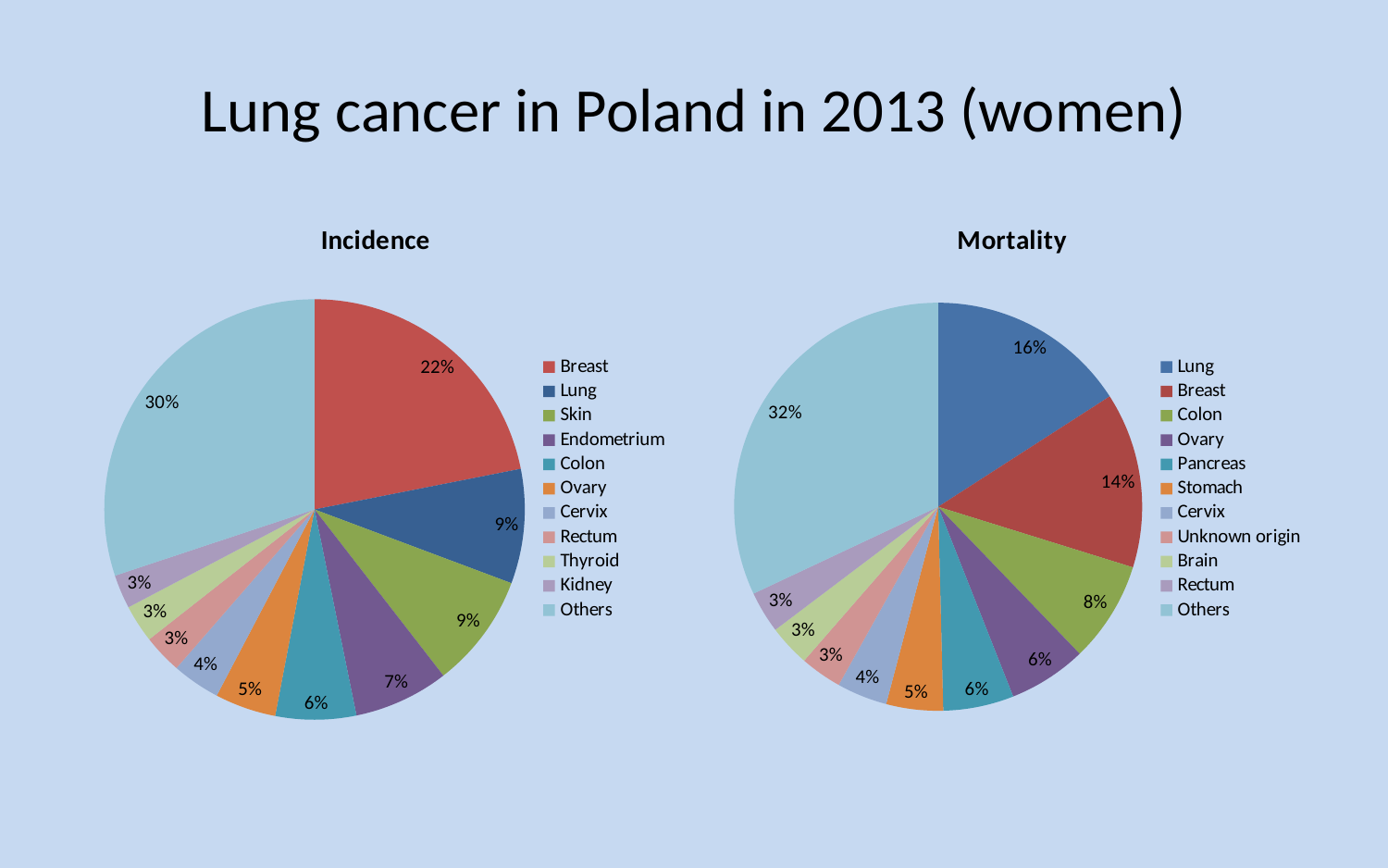
In the Mortality pie chart, what is the value for Stomach? 5% In the Incidence pie chart, what share does Breast account for? 22% How many categories does the legend of the Mortality pie chart list? 11 In the Incidence pie chart, which named cancer type (excluding Others) has the largest share? Breast In the Mortality pie chart, which category has the largest share overall? Others In the Mortality pie chart, what share does Lung account for? 16% In the Incidence pie chart, what colour is the Others slice? Light blue Which is larger: the Colon share in the Incidence chart or the Colon share in the Mortality chart? Mortality In the Mortality pie chart, what is the difference between the Lung share and the Breast share? 2% What type of chart is used for Incidence? Pie chart In the Incidence pie chart, what is the difference between the Breast share and the Lung share? 13% In the Incidence pie chart, what is the value for Endometrium? 7%